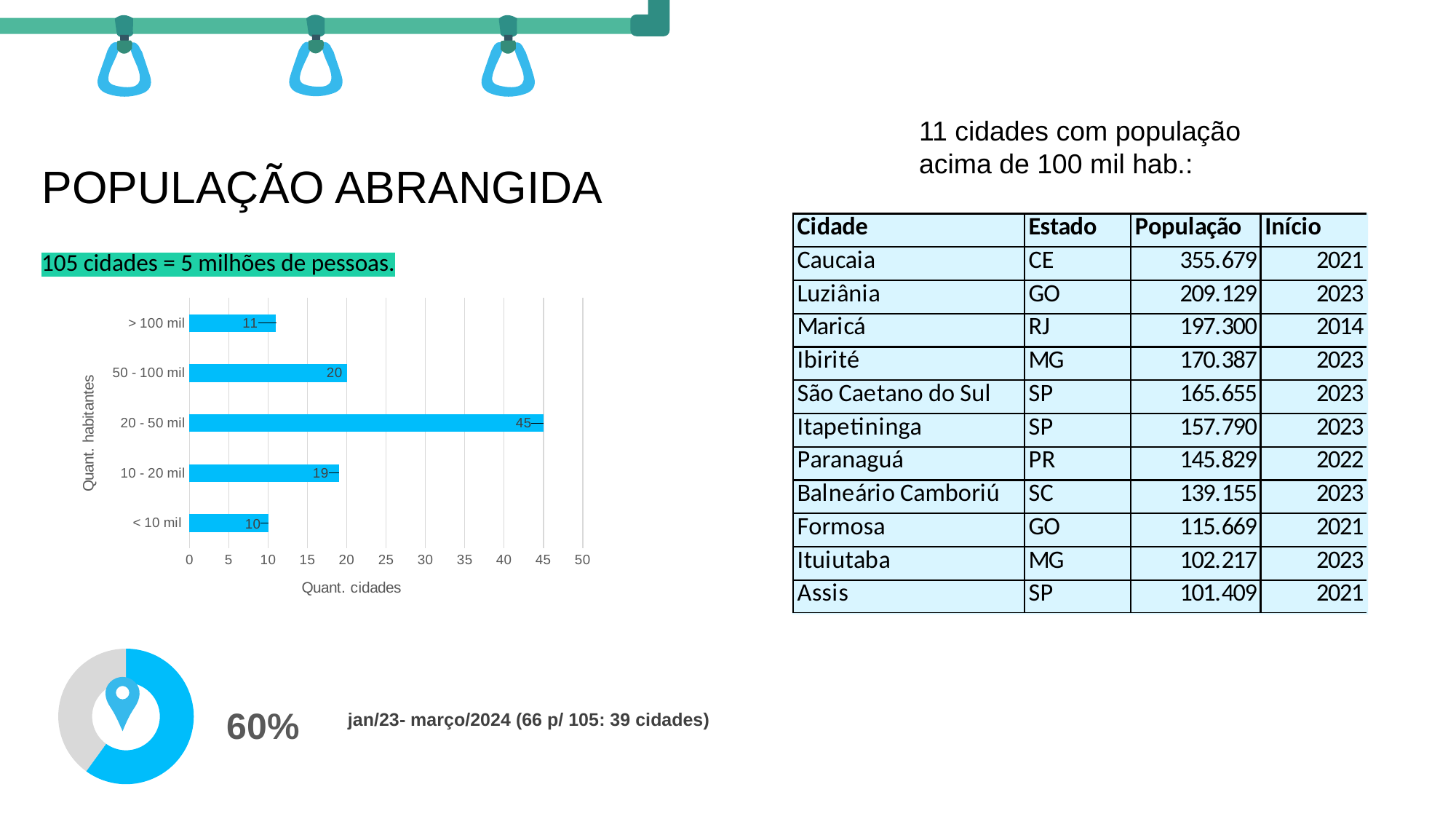
In the bar chart, which population range has the highest number of cities? 20 - 50 mil In the bar chart, what is the difference between the number of cities in the '20 - 50 mil' range and the '10 - 20 mil' range? 26 What type of chart is used to show the number of cities by population range? Bar chart What is the label of the horizontal axis of the bar chart? Quant. cidades In the bar chart, how many cities are in the '< 10 mil' population range? 10 What percentage is shown next to the donut chart at the bottom left of the slide? 60% In the bar chart, which population range has the lowest number of cities? < 10 mil In the bar chart, how many cities are in the '50 - 100 mil' population range? 20 In the bar chart, how many cities are in the '20 - 50 mil' population range? 45 In the bar chart, which has more cities: the '50 - 100 mil' range or the '10 - 20 mil' range? 50 - 100 mil In the bar chart, how many cities are in the '> 100 mil' population range? 11 How many population ranges (categories) are shown in the bar chart? 5